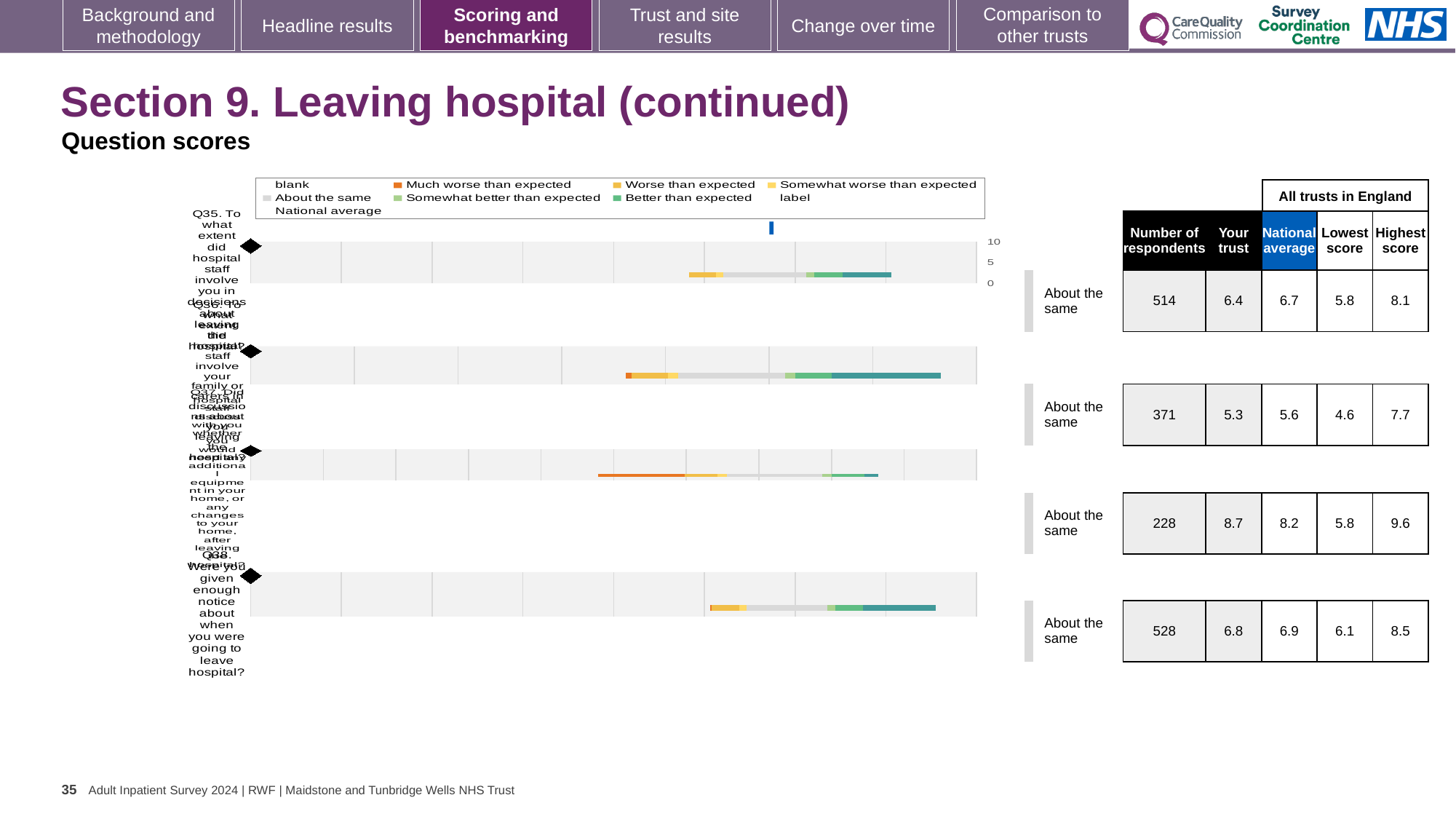
For the first chart (Q35), what is the difference between the national average and the 'Your trust' score? 0.3 For the first chart (Q35), what is the 'Your trust' score shown in the table? 6.4 What kind of chart is used to show the question scores on this slide? bar chart For the last chart (Q38), what is the highest score among all trusts in England? 8.5 For the last chart (Q38, given enough notice about leaving hospital), what is the 'Your trust' score? 6.8 For the first chart (Q35, involvement in decisions about leaving hospital), what is the number of respondents shown in the table? 514 For the last chart (Q38), which is larger: the 'Your trust' score or the national average? National average How many question bar charts are shown on the slide? 4 What benchmark category is shown next to the first chart (Q35)? About the same What colour represents 'Much worse than expected' in the legend? Orange Which row of the table has the highest 'Your trust' score? The third row (8.7) What is the lowest score shown in the table for the third row? 5.8